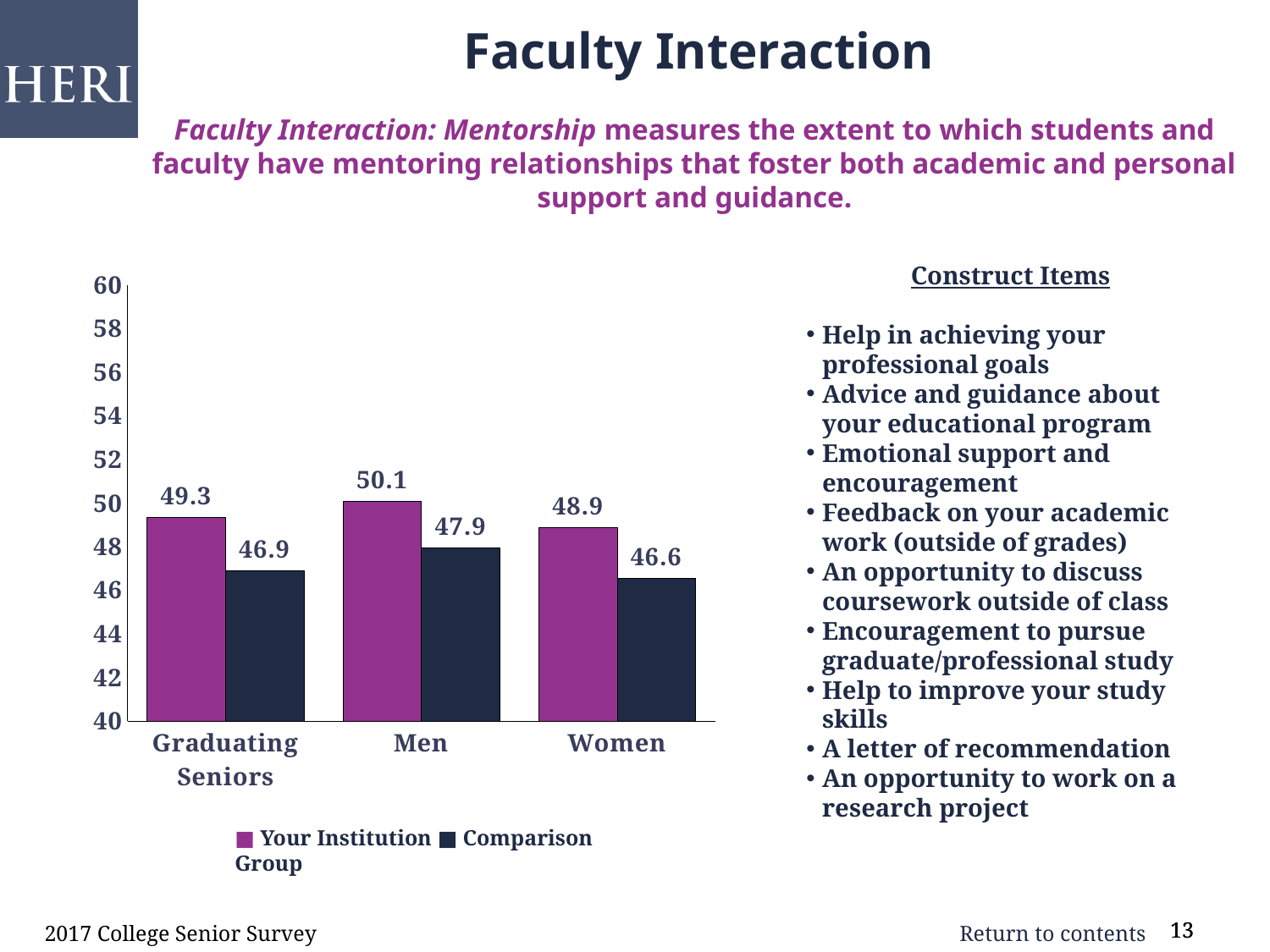
Which is larger for Women: Your Institution or the Comparison Group? Your Institution What is the difference between Your Institution and the Comparison Group for Graduating Seniors? 2.4 What is the difference between Your Institution and the Comparison Group for Men? 2.2 What is the value for Your Institution for Men? 50.1 Which category has the highest value for Your Institution? Men What colour are the bars for Your Institution? Purple What is the value for the Comparison Group for Women? 46.6 What kind of chart is shown on the slide? Bar chart What is the value for Your Institution for Graduating Seniors? 49.3 How many series does the legend list? 2 How many categories are shown on the x axis? 3 Which category has the lowest value for the Comparison Group? Women